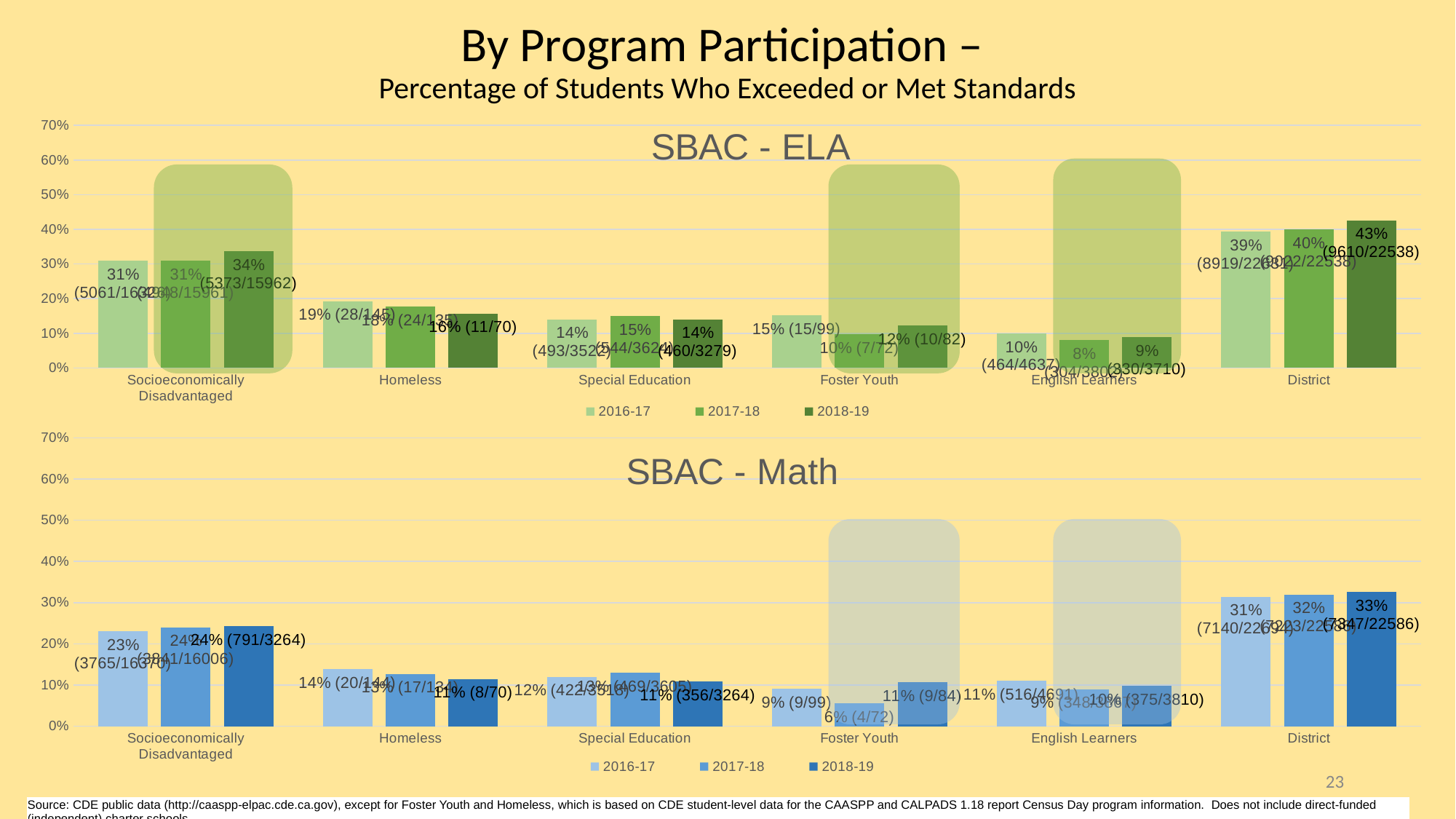
In the SBAC - ELA chart, which category has the lowest 2017-18 value? English Learners How many categories are shown on the x axis of the SBAC - Math chart? 6 In the SBAC - ELA chart, what is the value for Socioeconomically Disadvantaged in 2018-19? 34% In the SBAC - ELA chart, what is the difference between the District and Socioeconomically Disadvantaged values for 2018-19? 9% How many series does the legend of the SBAC - ELA chart list? 3 In the SBAC - Math chart, what is the value for District in 2018-19? 33% In the SBAC - Math chart, is the value for District in 2016-17 greater or less than 30%? greater What type of chart is the SBAC - Math chart? Bar chart In the SBAC - ELA chart, which category has the highest 2018-19 value? District In the SBAC - ELA chart, what is the value for District in 2018-19? 43% In the SBAC - Math chart, what is the value for Foster Youth in 2017-18? 6% In the SBAC - Math chart, which is larger for Homeless: the 2016-17 value or the 2018-19 value? 2016-17